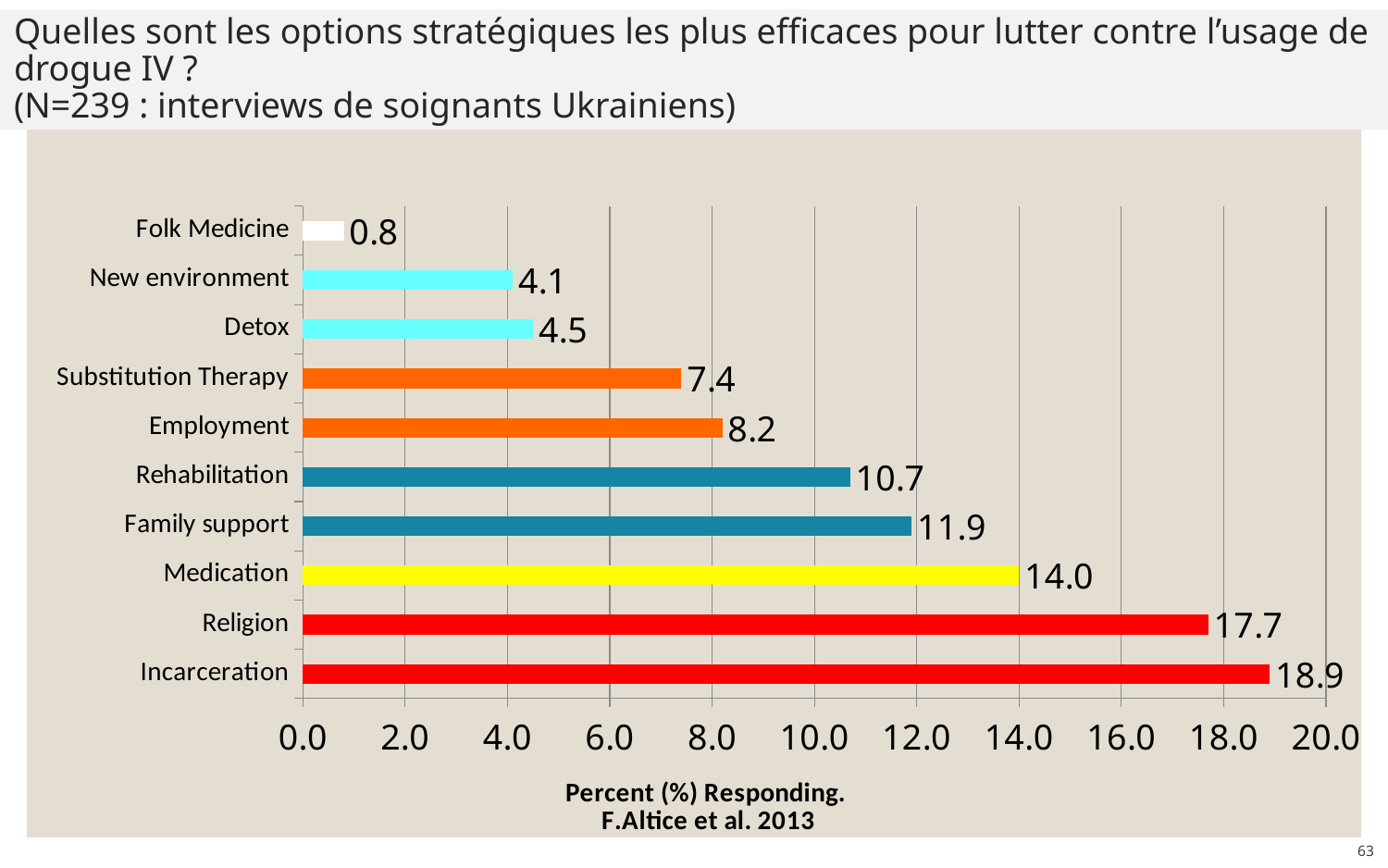
What is the difference between the values for Religion and Medication? 3.7 How many categories are shown in the chart? 10 What is the value for Incarceration? 18.9 Which category has the highest value? Incarceration What is the label of the horizontal axis? Percent (%) Responding. What is the value for Substitution Therapy? 7.4 What colour is the bar for Medication? yellow What is the value for Folk Medicine? 0.8 Is the value for Family support greater or less than 10.0? greater Which is larger, the value for Rehabilitation or the value for Employment? Rehabilitation What kind of chart is shown on the slide? bar chart Which category has the lowest value? Folk Medicine